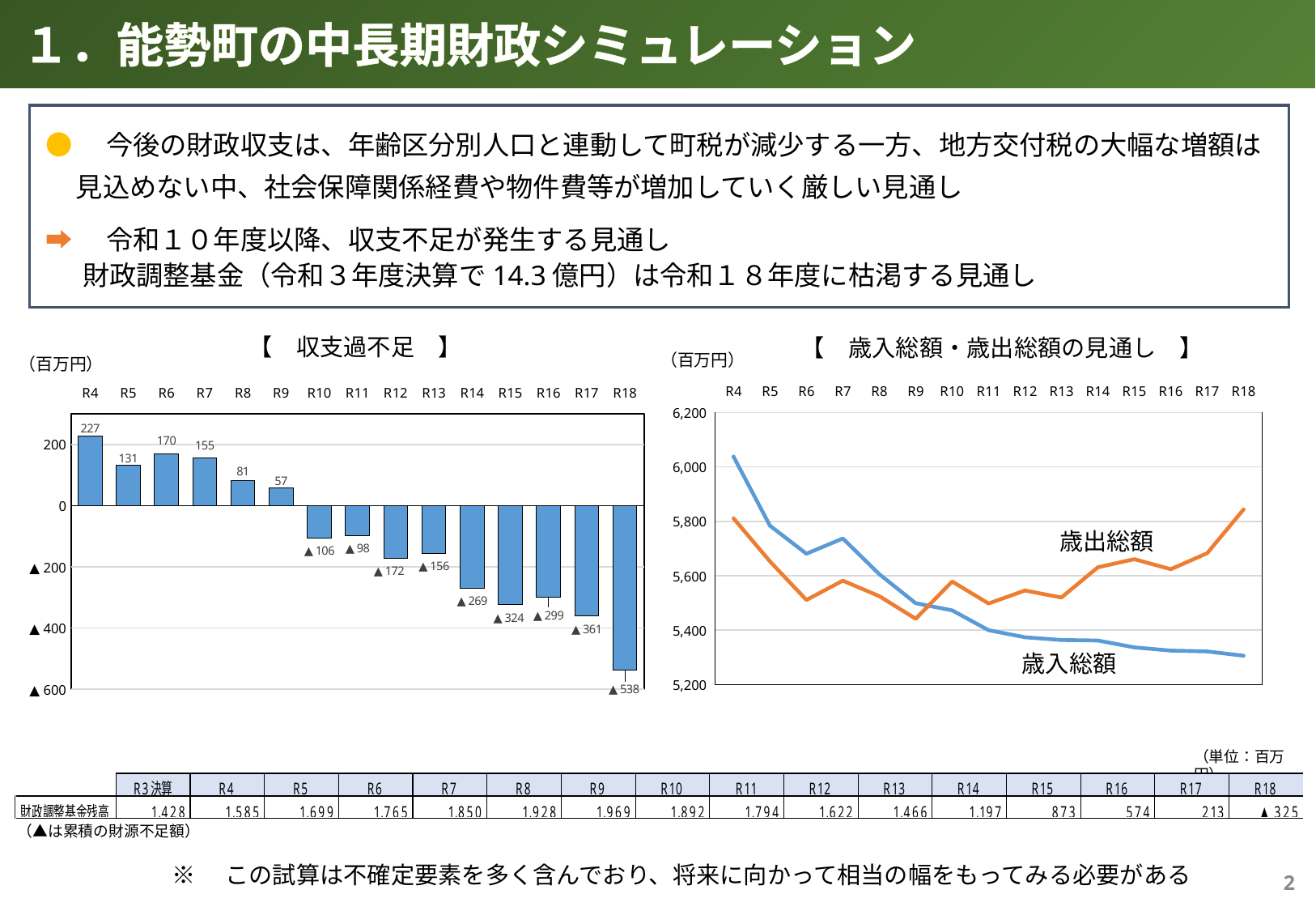
What kind of chart is the 収支過不足 chart? bar chart In the 収支過不足 chart, what is the value for R18? ▲538 In the 収支過不足 chart, what is the difference between the values for R4 and R5? 96 In the 歳入総額・歳出総額の見通し chart, is the value of 歳出総額 for R18 greater or less than 5,800? greater In the 歳入総額・歳出総額の見通し chart, is the value of 歳入総額 for R18 greater or less than 5,400? less In the 収支過不足 chart, which year has the lowest value? R18 In the 収支過不足 chart, which year has the highest value? R4 In the 歳入総額・歳出総額の見通し chart, does 歳入総額 rise or fall from R4 to R18? fall In the 収支過不足 chart, what is the value for R10? ▲106 In the 収支過不足 chart, which is larger, the value for R6 or the value for R7? R6 How many years are plotted in the 収支過不足 chart? 15 In the 収支過不足 chart, what is the value for R4? 227